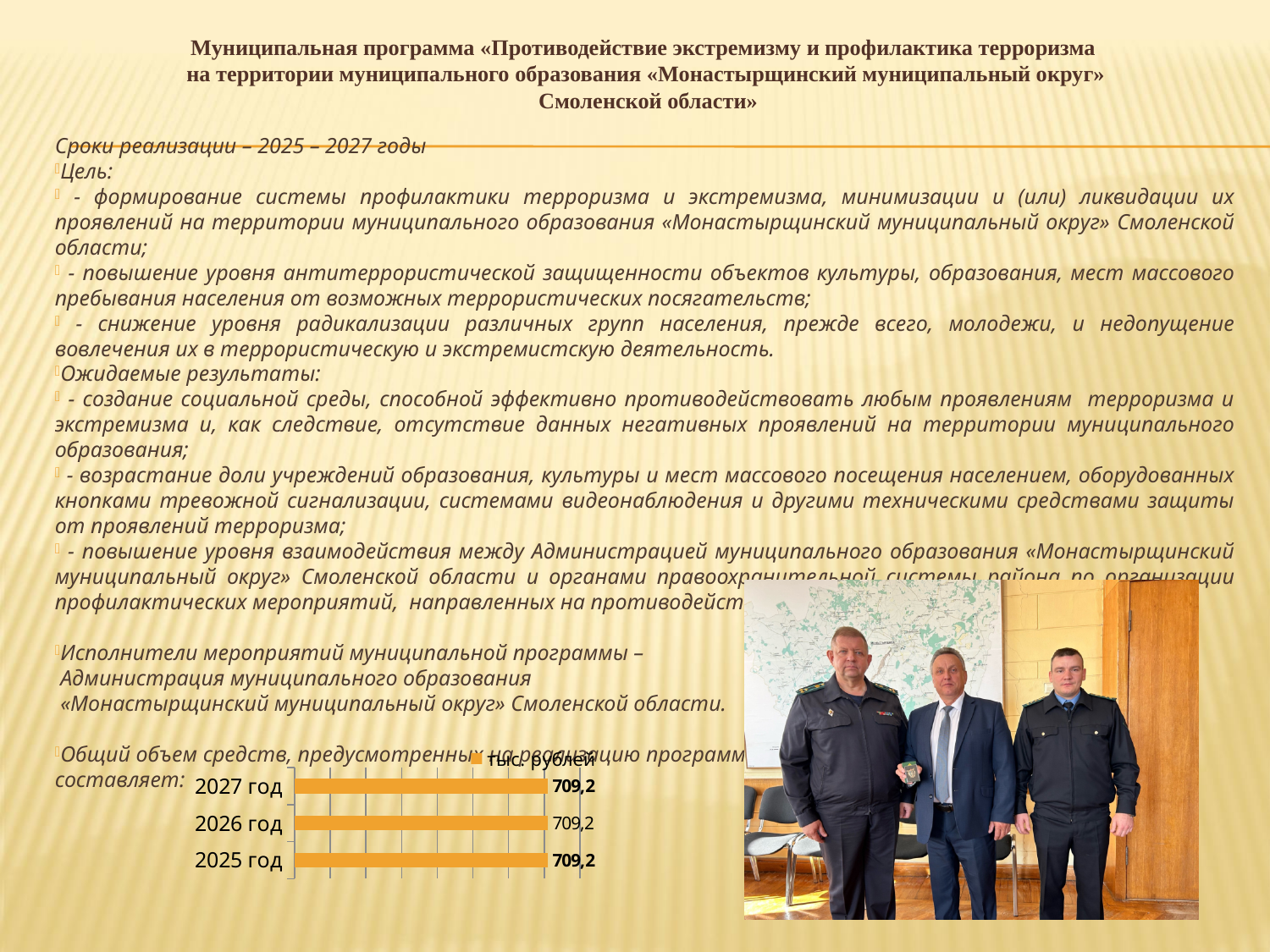
What is the legend entry of the chart? тыс. рублей What colour are the bars in the chart? orange Do the values change from 2025 год to 2027 год, or stay the same? stay the same What is the value for 2026 год in the bar chart? 709,2 What kind of chart is shown on the slide? bar chart What is the value for 2027 год in the bar chart? 709,2 What is the total of the values for 2025 год, 2026 год and 2027 год? 2127,6 How many categories (years) are shown in the bar chart? 3 What is the value for 2025 год in the bar chart? 709,2 How many series does the chart legend list? 1 What is the difference between the values for 2027 год and 2025 год? 0